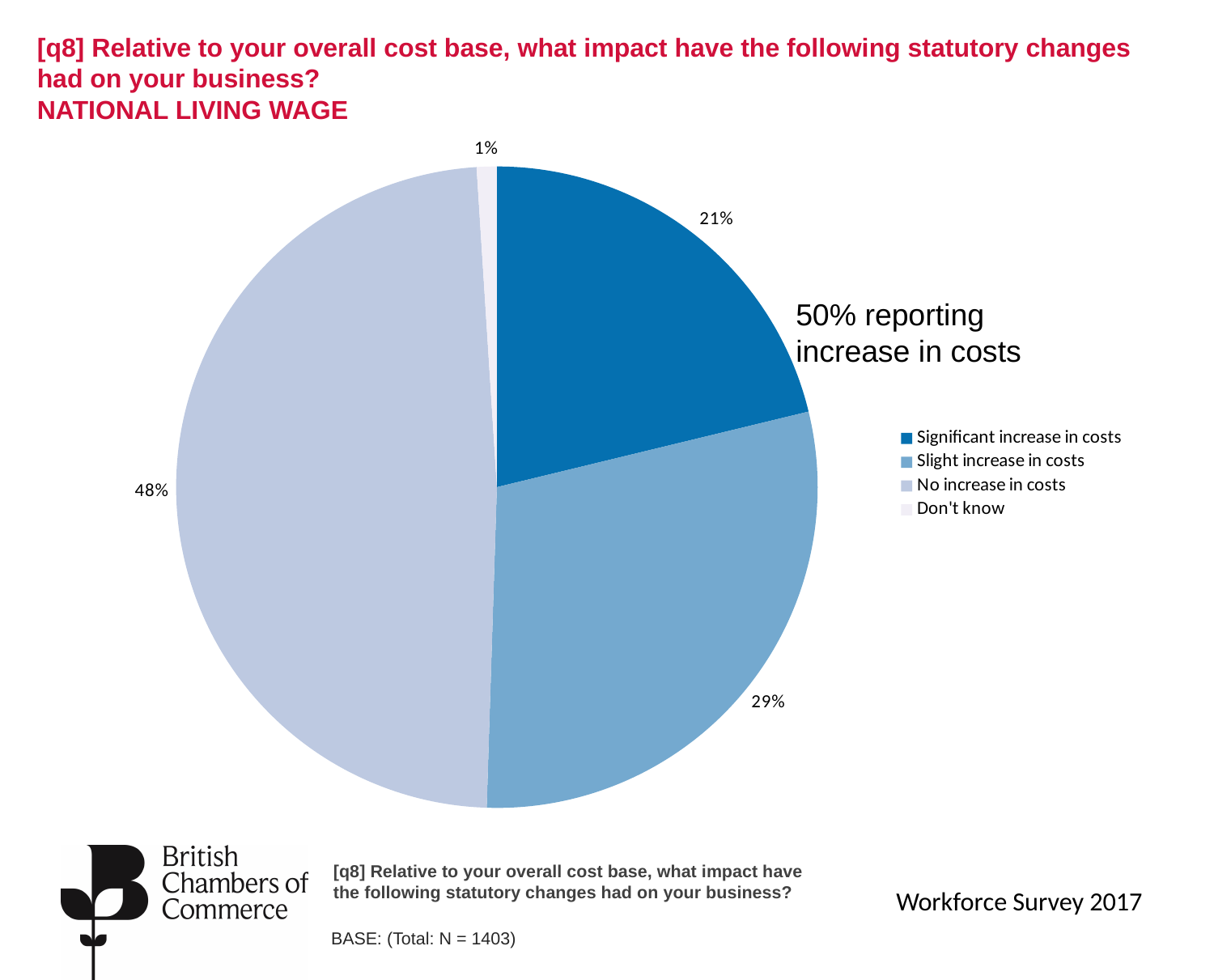
What kind of chart is shown on the slide? Pie chart What is the combined share of 'Significant increase in costs' and 'Slight increase in costs'? 50% How many categories does the legend list? 4 What percentage of respondents reported no increase in costs? 48% Which is larger: 'Slight increase in costs' or 'Significant increase in costs'? Slight increase in costs What is the base size (N) stated on the slide? 1403 What percentage of respondents reported a slight increase in costs? 29% What is the difference in percentage points between 'No increase in costs' and 'Slight increase in costs'? 19 Which category has the smallest share of the pie? Don't know Which category has the largest share of the pie? No increase in costs What percentage of respondents reported a significant increase in costs? 21% What percentage of respondents answered 'Don't know'? 1%